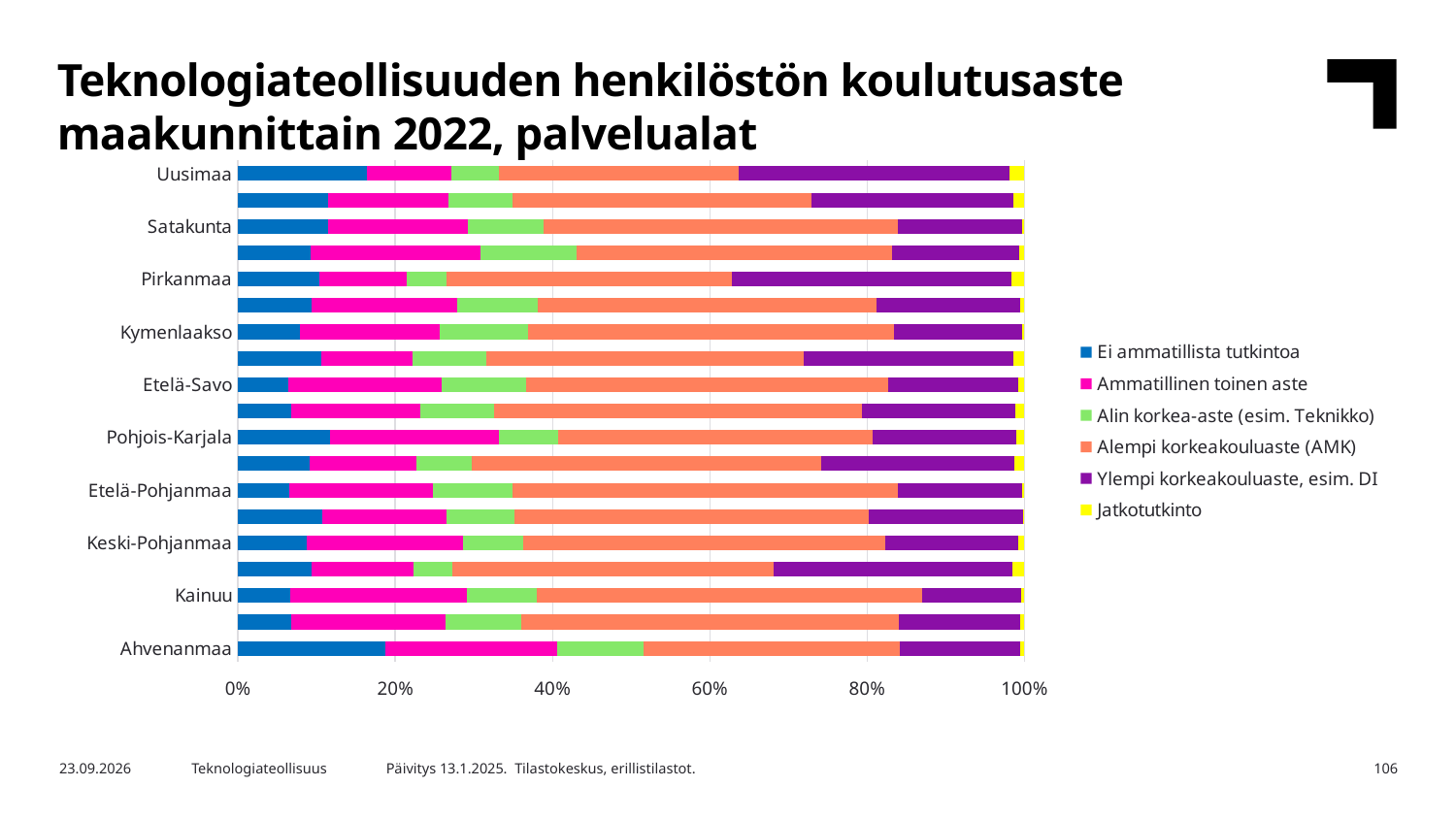
Is the 'Ylempi korkeakouluaste, esim. DI' share for Uusimaa greater or less than 20%? greater What kind of chart is shown on the slide? Stacked bar chart Is the 'Alempi korkeakouluaste (AMK)' share for Kainuu greater or less than 40%? greater How many series does the legend list? 6 Is the 'Ei ammatillista tutkintoa' share for Uusimaa greater or less than 20%? less Which has the larger 'Ylempi korkeakouluaste, esim. DI' share, Uusimaa or Kainuu? Uusimaa Which has the larger 'Ei ammatillista tutkintoa' share, Ahvenanmaa or Kainuu? Ahvenanmaa How many bars (regions) are plotted in the chart? 19 Which colour represents 'Jatkotutkinto' in the legend? Yellow What is the title of the chart on the slide? Teknologiateollisuuden henkilöstön koulutusaste maakunnittain 2022, palvelualat Which region has the highest 'Ei ammatillista tutkintoa' share? Ahvenanmaa